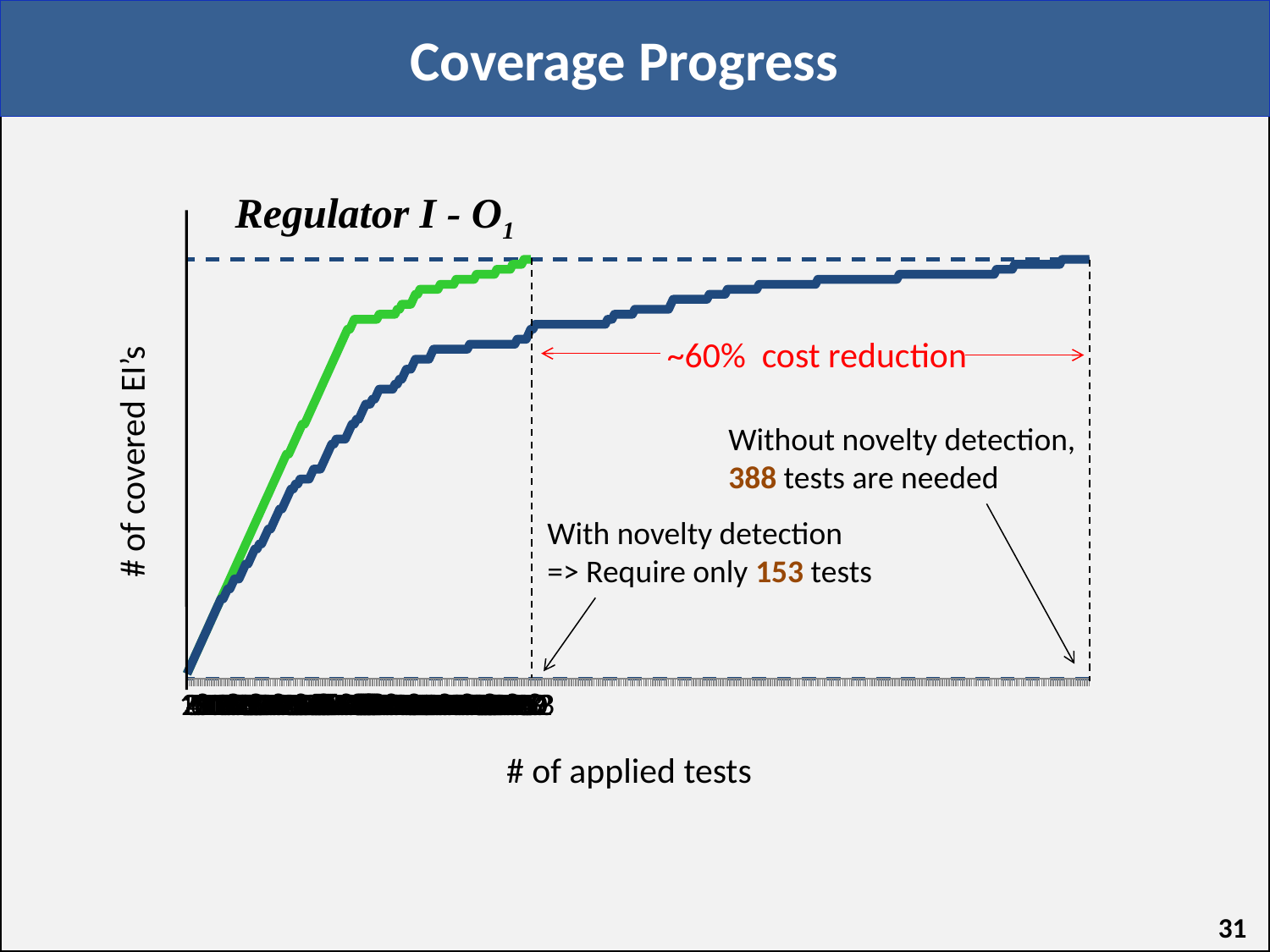
What is the label of the vertical axis? # of covered EI's What cost reduction does the chart annotation state? ~60% How many lines are plotted on the chart? 2 Is the number of tests needed without novelty detection greater or less than 300? greater How many more tests are needed without novelty detection than with novelty detection? 235 According to the annotation, how many tests are required with novelty detection? 153 What is the title of the chart? Regulator I - O1 Which line reaches the dashed full-coverage level first, the green line or the blue line? green line According to the annotation, how many tests are needed without novelty detection? 388 Do the plotted lines rise or fall as the number of applied tests increases? rise What kind of chart is shown on the slide? line chart Which approach needs more tests to reach full coverage: with novelty detection or without novelty detection? without novelty detection